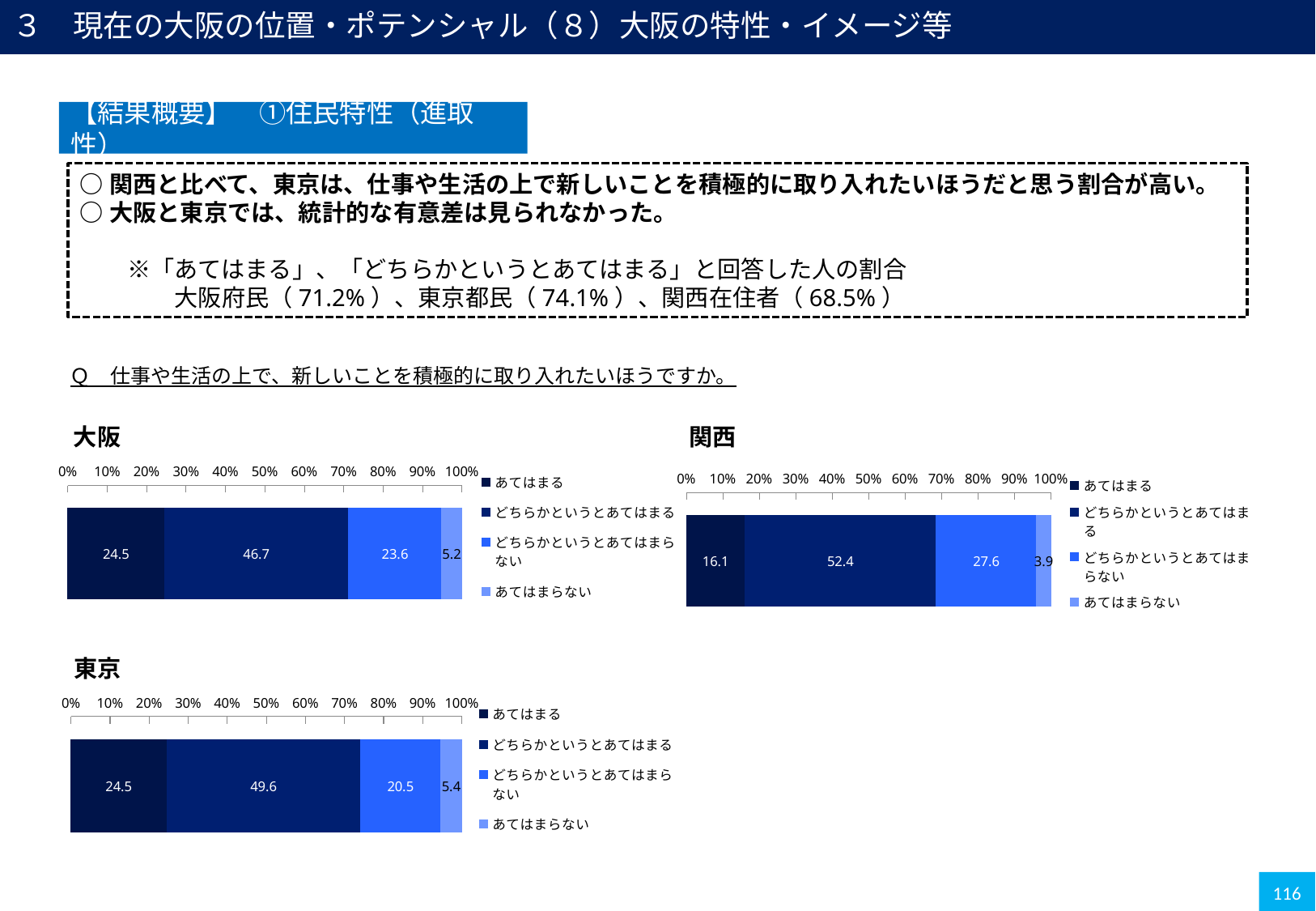
How many series does the legend of the 東京 chart list? 4 In the 関西 chart, what is the difference between どちらかというとあてはまる and どちらかというとあてはまらない? 24.8 Which is larger: あてはまる in the 大阪 chart or あてはまる in the 関西 chart? 大阪 What kind of chart is the 大阪 chart? Stacked bar chart In the 関西 chart, what is the value for どちらかというとあてはまる? 52.4 What is the first legend entry in the 関西 chart? あてはまる In the 東京 chart, what is the value for どちらかというとあてはまらない? 20.5 In the 関西 chart, what is the value for あてはまらない? 3.9 In the 大阪 chart, what is the value for あてはまる? 24.5 In the 東京 chart, what is the total of あてはまる and どちらかというとあてはまる? 74.1 In the 東京 chart, which segment has the largest value? どちらかというとあてはまる In the 大阪 chart, which segment has the smallest value? あてはまらない